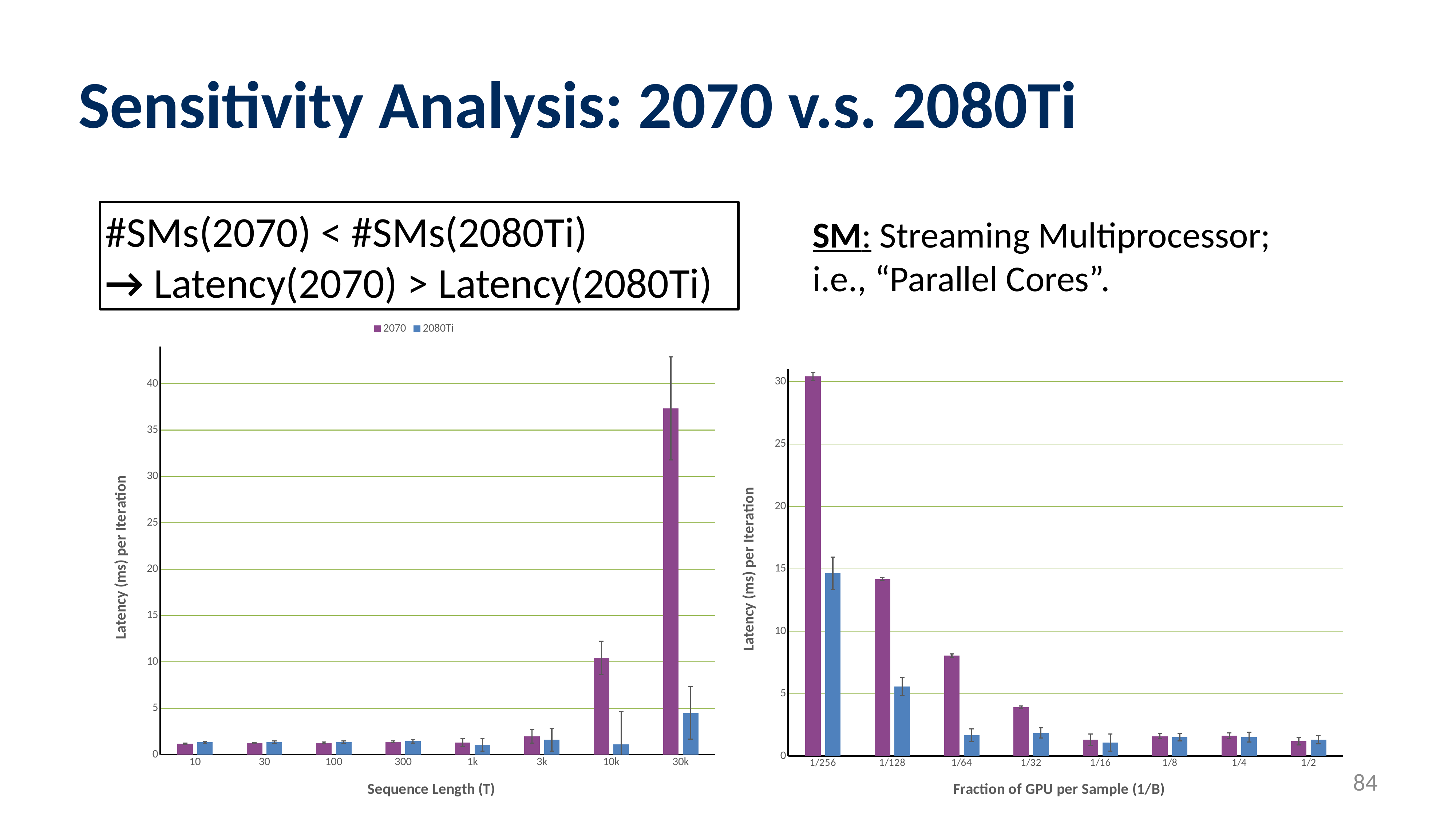
In the left chart (Sequence Length), is the 2080Ti latency at 30k greater or less than 5? less In the right chart (Fraction of GPU per Sample), is the 2070 latency at 1/32 greater or less than 5? less In the right chart (Fraction of GPU per Sample), at which fraction is the 2070 latency highest? 1/256 In the left chart (Sequence Length), how many sequence-length categories are shown on the x axis? 8 In the left chart (Sequence Length), which has the larger latency at 10k, 2070 or 2080Ti? 2070 How many series does the legend list? 2 In the right chart (Fraction of GPU per Sample), is the 2070 latency at 1/256 greater or less than 25? greater What is the y-axis label of the right chart? Latency (ms) per Iteration What kind of chart is the left chart (Sequence Length)? bar chart In the left chart (Sequence Length), at which sequence length is the 2070 latency highest? 30k In the right chart (Fraction of GPU per Sample), which has the larger latency at 1/64, 2070 or 2080Ti? 2070